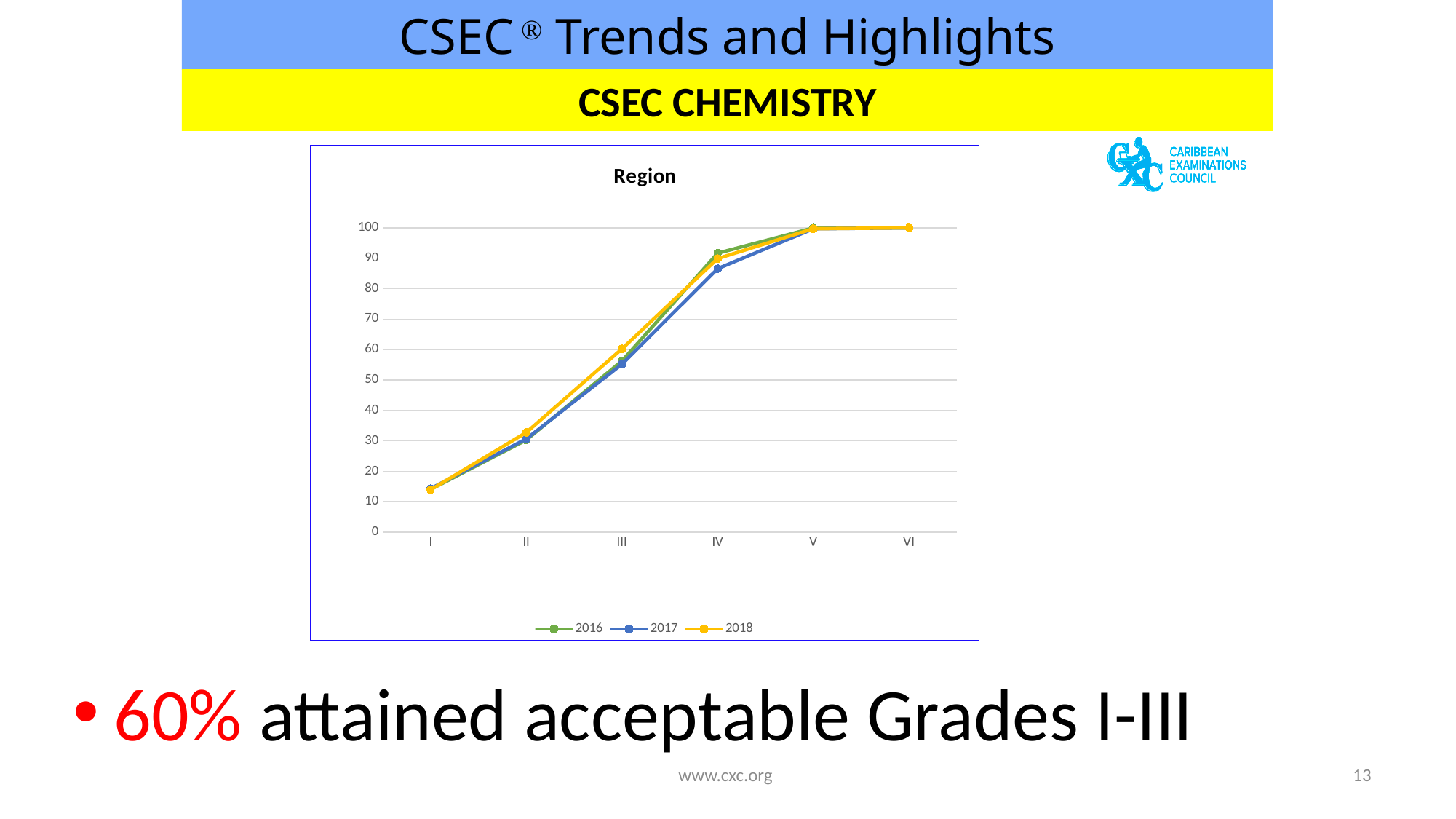
Which years are listed in the chart legend? 2016, 2017, 2018 Is the value for 2018 at grade III greater or less than 50? greater Is the value for 2017 at grade I greater or less than 20? less Is the value for 2017 at grade IV greater or less than 80? greater What kind of chart is shown on the slide? line chart What is the title of the chart? Region How many grade categories are shown on the x axis? 6 Do the values for 2018 rise or fall from grade I to grade V? rise How many series does the legend list? 3 For the 2017 series, at which grade is the value lowest? I At grade IV, which series has the larger value, 2016 or 2017? 2016